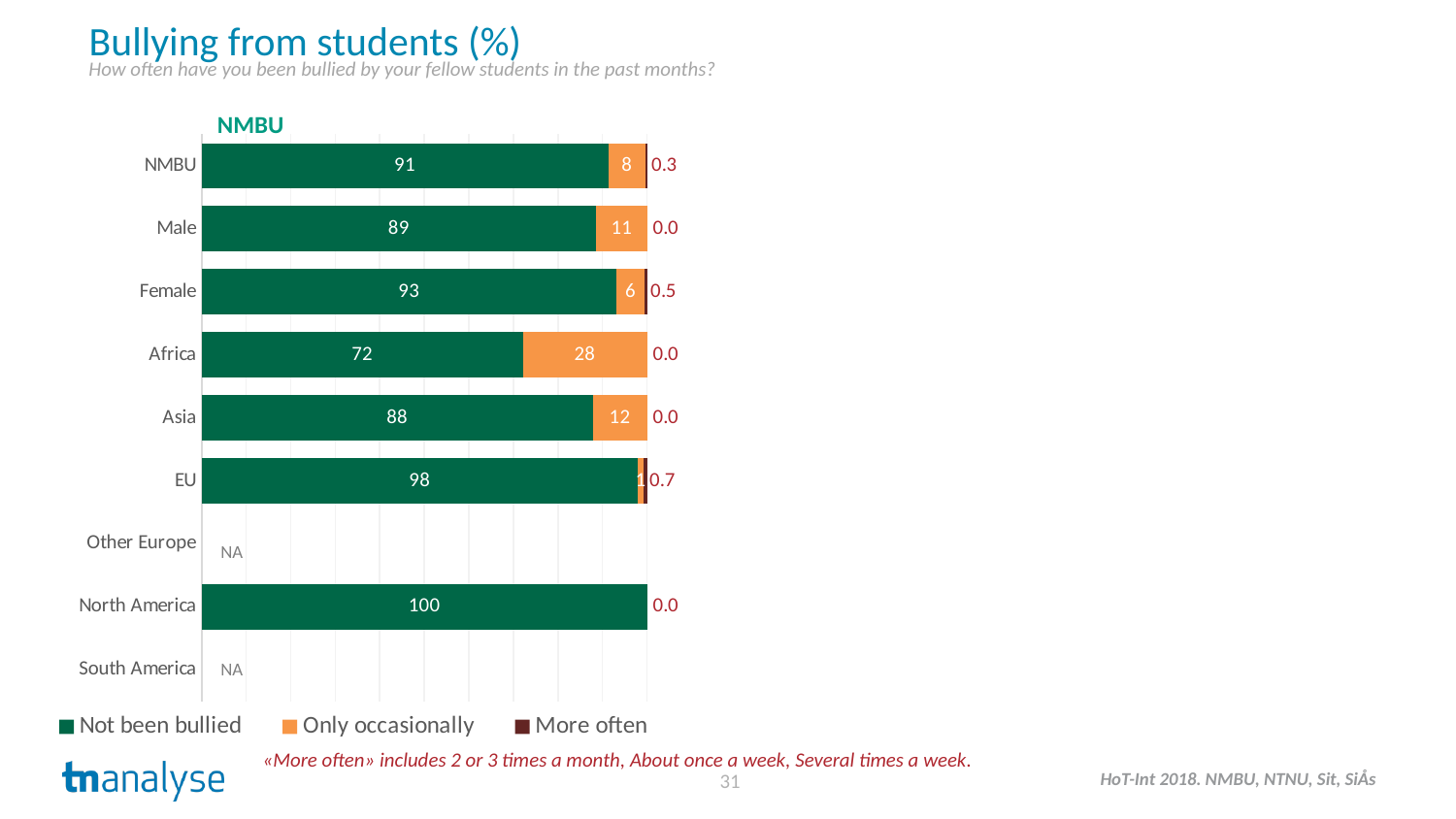
Which categories are shown as NA in the chart? Other Europe and South America Which category has the highest 'Not been bullied' value? North America What is the 'More often' value for EU? 0.7 Which category has the lowest 'Not been bullied' value among those with data? Africa What is the difference between the 'Not been bullied' values for Female and Male? 4 How many series does the legend list? 3 What is the 'Not been bullied' value for Africa? 72 Which category has the highest 'Only occasionally' value? Africa Which is larger, the 'Only occasionally' value for Asia or for NMBU? Asia What kind of chart is shown on the slide? Stacked bar chart What is the 'More often' value for Female? 0.5 What is the 'Only occasionally' value for Male? 11